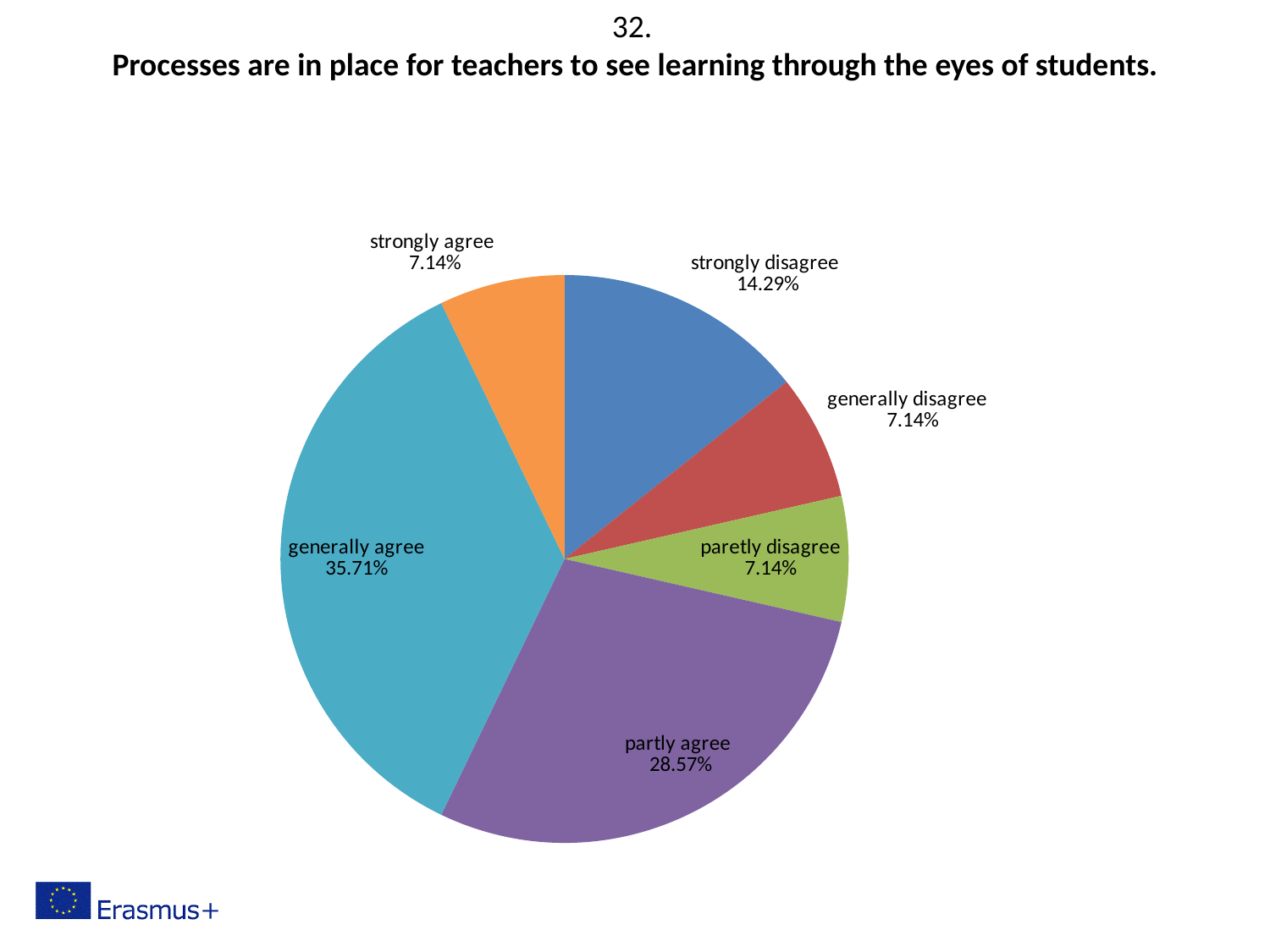
What percentage of respondents chose 'strongly disagree'? 14.29% What percentage of respondents chose 'partly agree'? 28.57% Which response category has the largest share of the pie? generally agree What percentage of respondents chose 'generally agree'? 35.71% What is the difference between the 'strongly disagree' and 'strongly agree' shares? 7.15% How many response categories have a share of 7.14%? 3 What is the difference between the 'generally agree' and 'partly agree' shares? 7.14% What type of chart is shown on the slide? pie chart What is the title of the chart? Processes are in place for teachers to see learning through the eyes of students. What percentage of respondents chose 'strongly agree'? 7.14% Which is larger, the share for 'strongly disagree' or the share for 'generally disagree'? strongly disagree How many slices does the pie chart have? 6